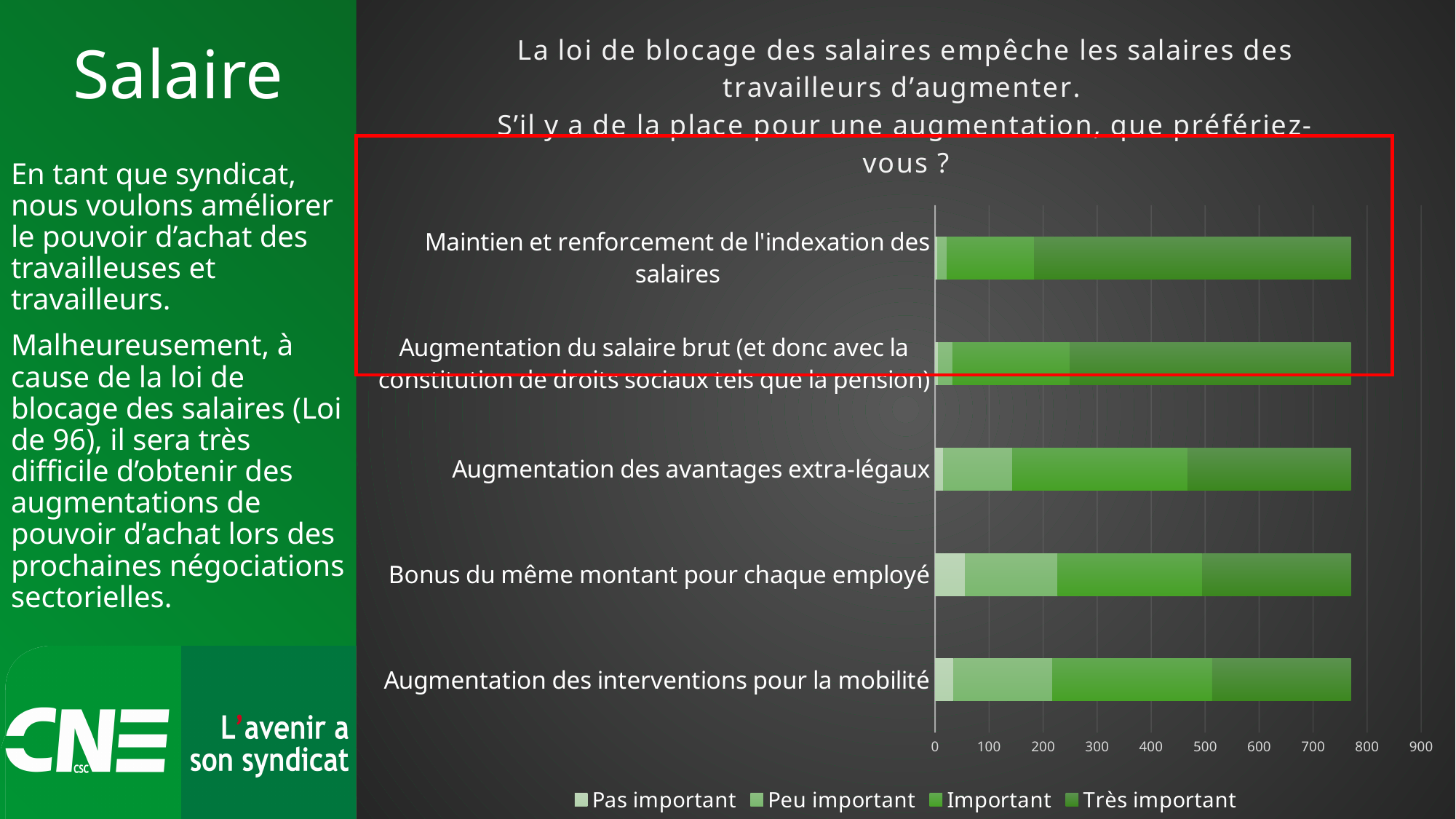
How many categories (answer options) are plotted in the chart? 5 Which category has the largest 'Pas important' segment? Bonus du même montant pour chaque employé What kind of chart is shown on the slide? Stacked bar chart How many series does the chart legend list? 4 Which series is listed last in the chart legend? Très important Is the 'Pas important' segment for 'Bonus du même montant pour chaque employé' greater or less than 100? less Is the total bar length for 'Augmentation des avantages extra-légaux' greater or less than 800? less Is the 'Très important' segment for 'Maintien et renforcement de l'indexation des salaires' greater or less than 500? greater Which series is listed first in the chart legend? Pas important Which category has a larger 'Important' segment: 'Bonus du même montant pour chaque employé' or 'Maintien et renforcement de l'indexation des salaires'? Bonus du même montant pour chaque employé Which category has a larger 'Très important' segment: 'Maintien et renforcement de l'indexation des salaires' or 'Augmentation des avantages extra-légaux'? Maintien et renforcement de l'indexation des salaires